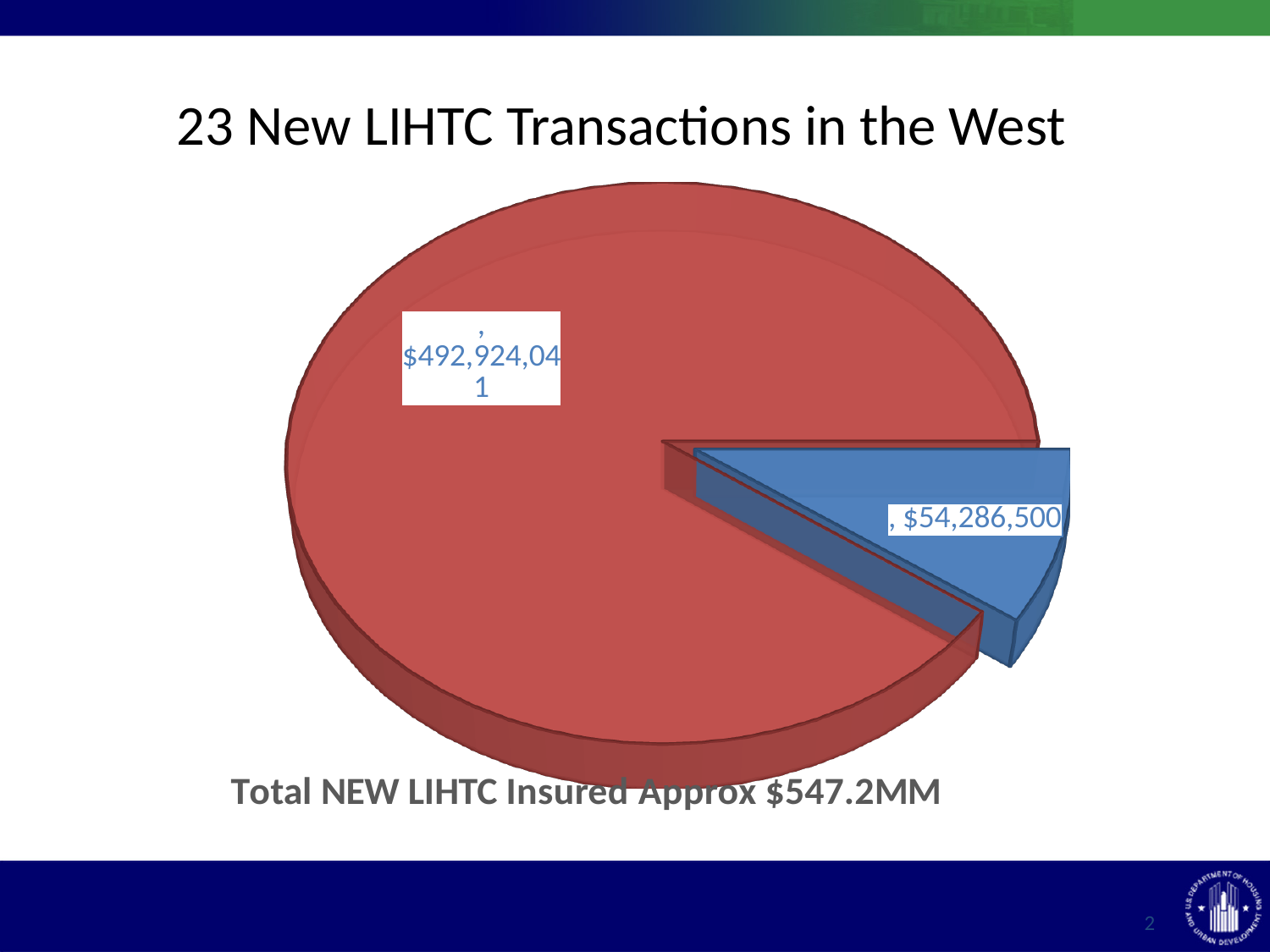
What value is labelled on the red slice of the pie chart? $492,924,041 What kind of chart is shown on the slide? Pie chart What is the title of the chart on the slide? Total NEW LIHTC Insured Approx $547.2MM Is the red slice or the blue slice of the pie chart larger? The red slice What is the sum of the two slice values shown on the pie chart? $547,210,541 Which slice of the pie chart is the smallest? The blue slice ($54,286,500) According to the caption below the chart, what is the approximate total of new LIHTC insured? Approx $547.2MM What value is labelled on the blue slice of the pie chart? $54,286,500 What is the difference between the red slice value and the blue slice value? $438,637,541 How many slices does the pie chart have? 2 Which slice of the pie chart is the largest? The red slice ($492,924,041)